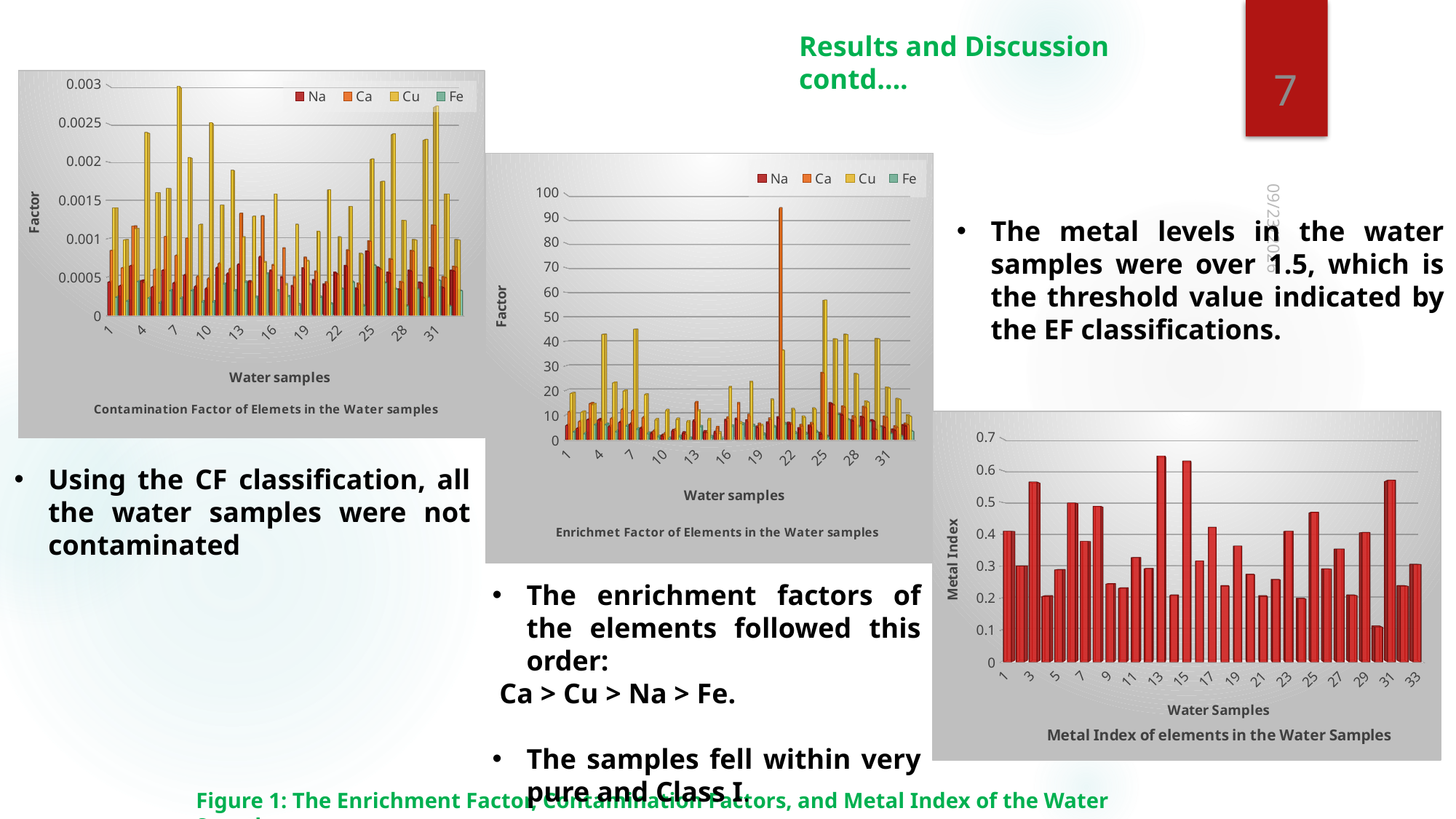
In the 'Metal Index of elements in the Water Samples' chart, is the lowest bar greater or less than 0.2? less In the 'Contamination Factor of Elemets in the Water samples' chart, which elements are listed in the legend? Na, Ca, Cu, Fe What is the y-axis title of the 'Metal Index of elements in the Water Samples' chart? Metal Index In the 'Contamination Factor of Elemets in the Water samples' chart, is the tallest Cu bar greater or less than 0.0025? greater In the 'Enrichmet Factor of Elements in the Water samples' chart, is the tallest Ca bar greater or less than 90? greater In the 'Enrichmet Factor of Elements in the Water samples' chart, how many series does the legend list? 4 How many water samples are plotted in the 'Metal Index of elements in the Water Samples' chart? 33 In the 'Enrichmet Factor of Elements in the Water samples' chart, which series has the single tallest bar? Ca In the 'Contamination Factor of Elemets in the Water samples' chart, which series has the tallest bars overall? Cu What kind of chart is the 'Contamination Factor of Elemets in the Water samples' chart? bar chart